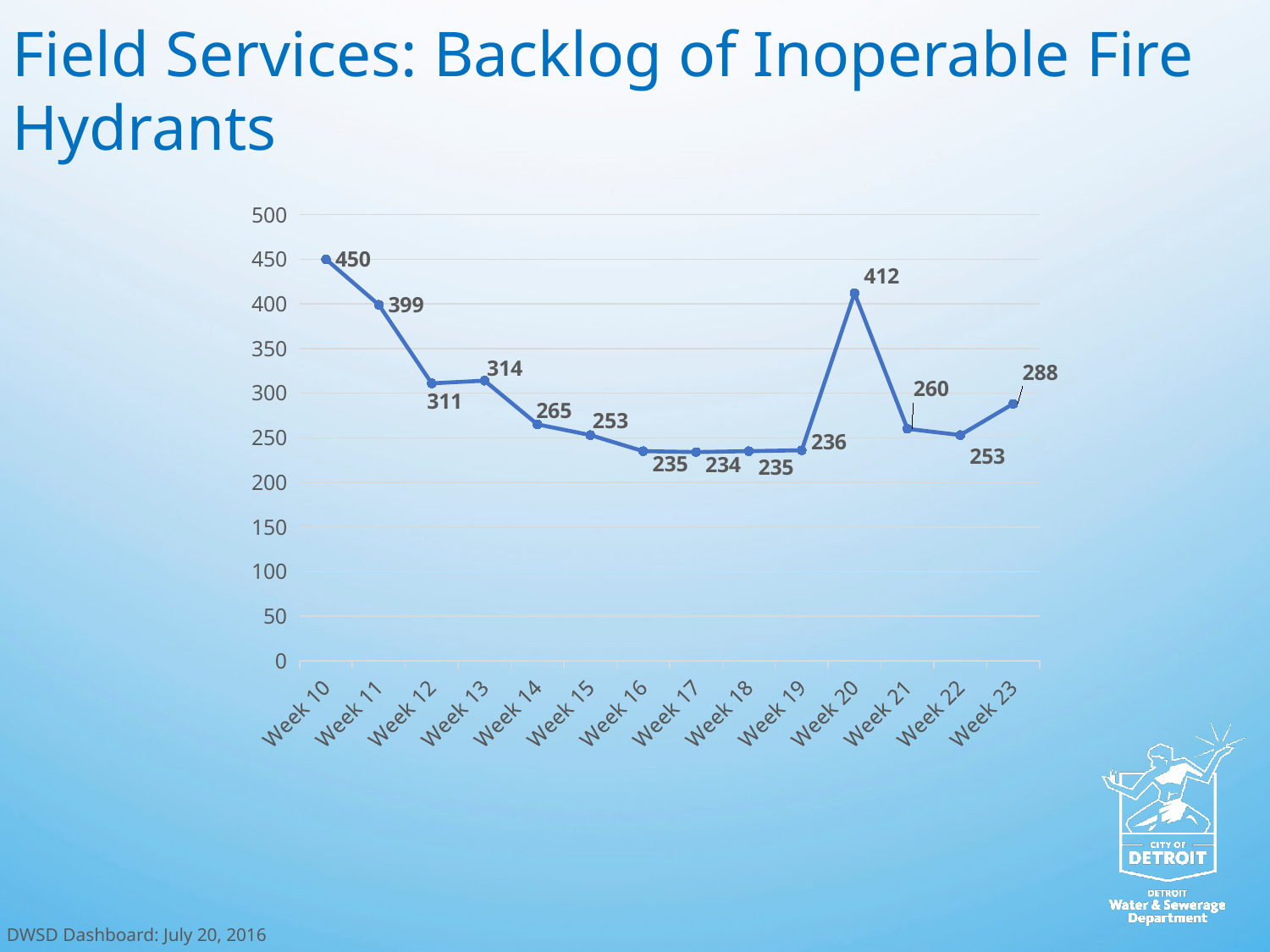
Does the backlog rise or fall from Week 10 to Week 13? Fall Which week has the highest backlog value? Week 10 Which is larger, the value for Week 13 or the value for Week 12? Week 13 What is the difference between the Week 20 value and the Week 21 value? 152 What is the value plotted for Week 20? 412 Is the value for Week 20 greater or less than 400? greater What is the backlog of inoperable fire hydrants in Week 10? 450 Which week has the lowest backlog value? Week 17 What is the difference between the Week 10 value and the Week 11 value? 51 What kind of chart is shown on the slide? Line chart What is the value plotted for Week 23? 288 How many weeks are plotted on the chart? 14